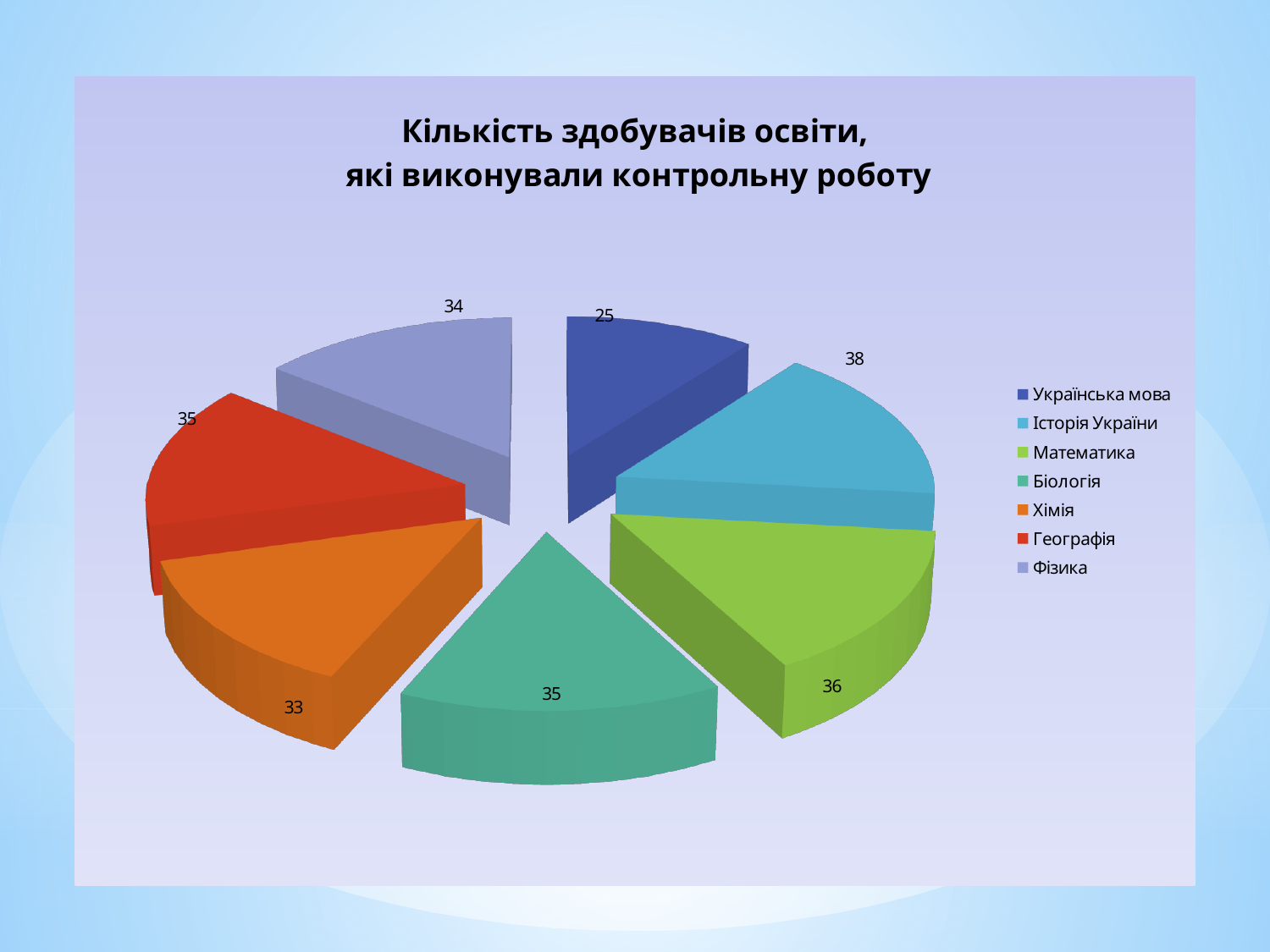
What is the value for Хімія? 33 Which category has the highest value? Історія України What kind of chart is shown on the slide? pie chart What is the total of all the values in the pie chart? 236 How many categories does the pie chart have? 7 What is the difference between the values for Історія України and Українська мова? 13 What is the value for Українська мова? 25 What is the value for Історія України? 38 What is the title of the chart? Кількість здобувачів освіти, які виконували контрольну роботу What is the value for Фізика? 34 Which is larger, the value for Математика or the value for Фізика? Математика Which category has the lowest value? Українська мова